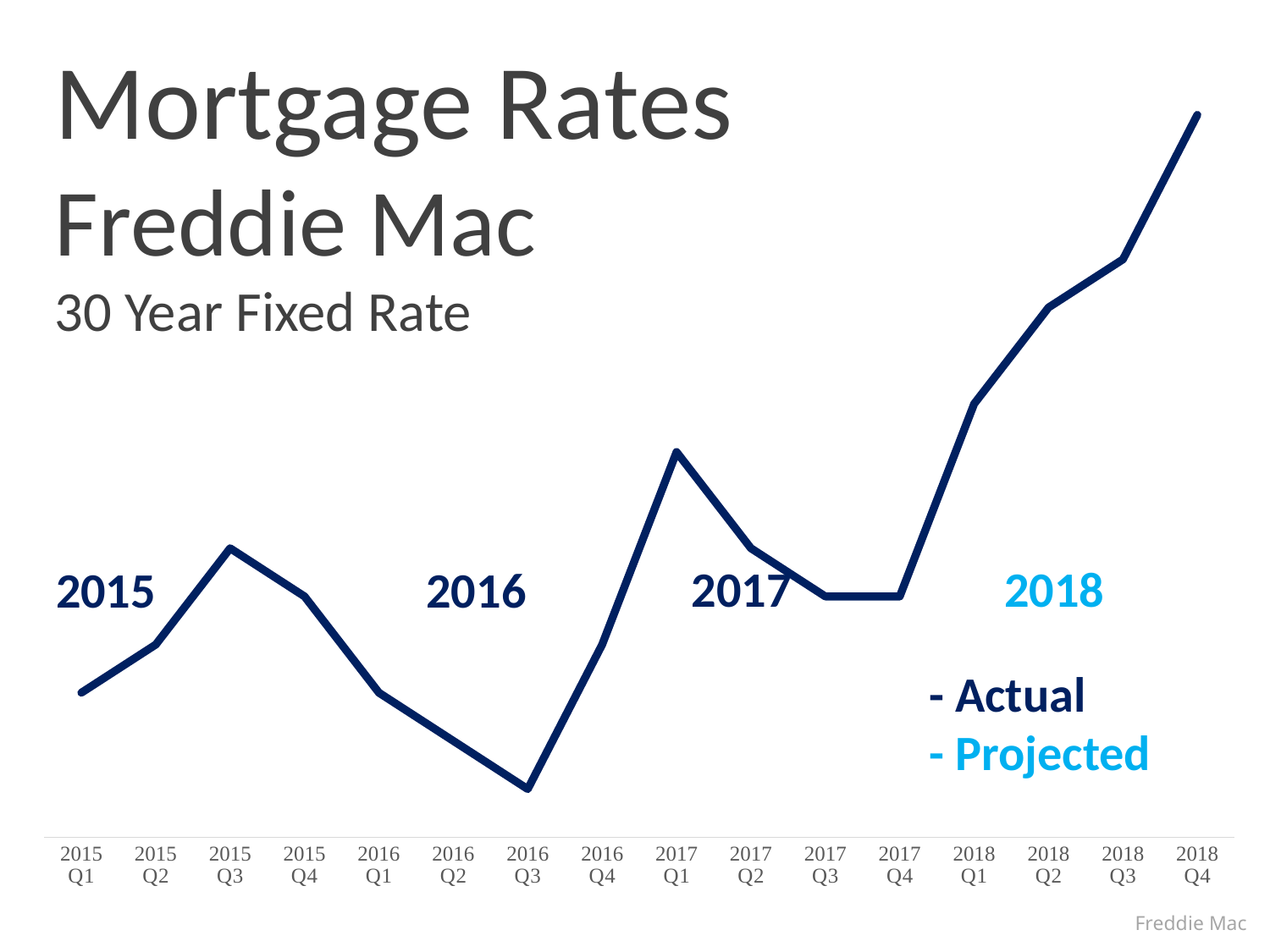
Which is higher, the rate in 2017 Q1 or the rate in 2017 Q3? 2017 Q1 Do the rates rise or fall from 2017 Q4 to 2018 Q4? rise Which is higher, the rate in 2017 Q4 or the rate in 2018 Q1? 2018 Q1 How many quarterly points are plotted on the x axis? 16 Do the rates rise or fall from 2015 Q3 to 2016 Q3? fall What is the title of the chart? Mortgage Rates Freddie Mac 30 Year Fixed Rate Which is higher, the rate in 2015 Q3 or the rate in 2016 Q3? 2015 Q3 Which year is labelled as projected rather than actual? 2018 Which quarter has the highest mortgage rate on the chart? 2018 Q4 How many entries does the legend list? 2 Which quarter has the lowest mortgage rate on the chart? 2016 Q3 What kind of chart is shown on the slide? line chart